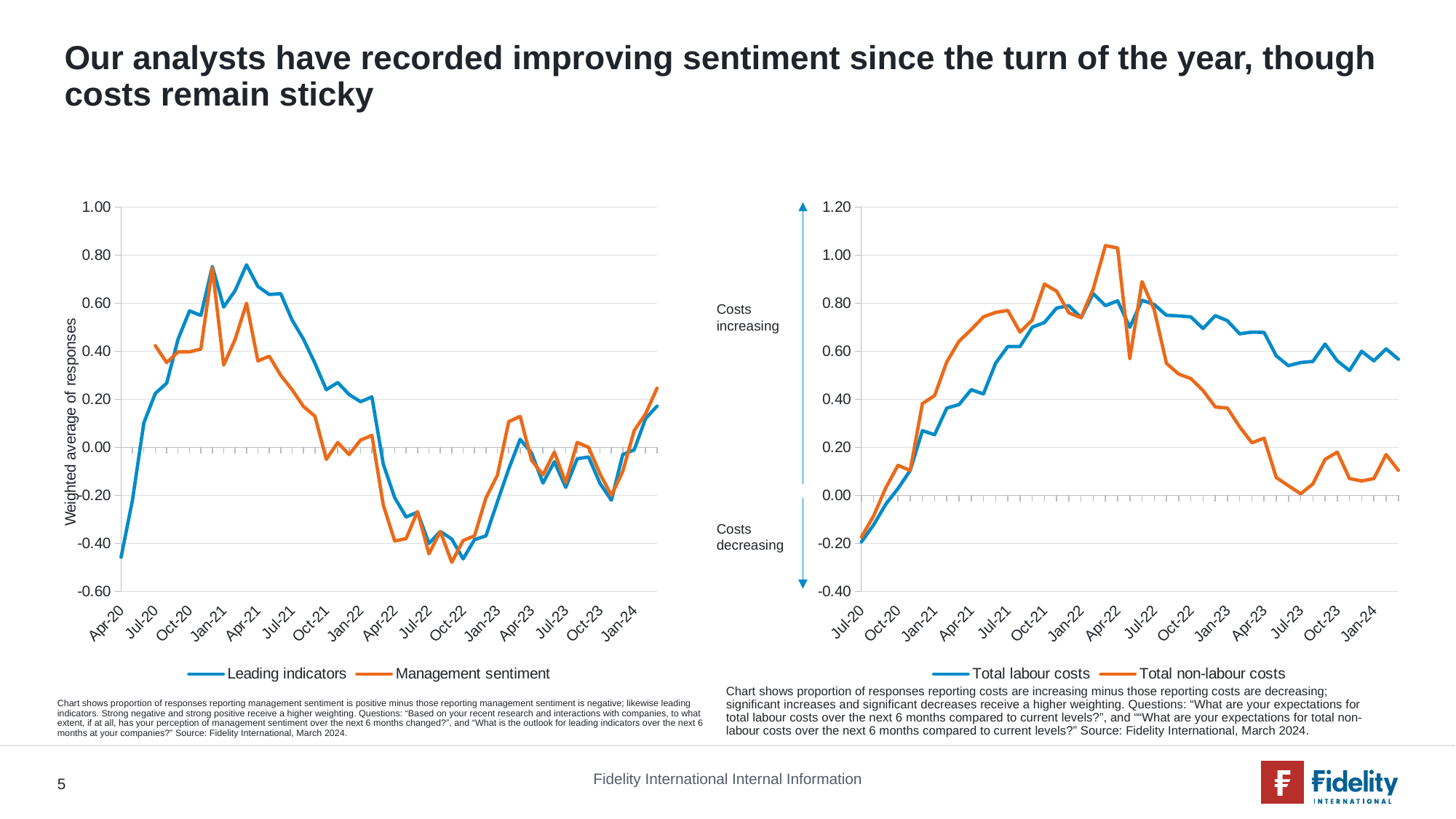
In the right chart, is the value for Total labour costs at Jan-24 greater or less than 0.40? greater In the left chart, which series is higher at Apr-21, Leading indicators or Management sentiment? Leading indicators What are the two series named in the legend of the left chart? Leading indicators and Management sentiment In the left chart, is the value for Management sentiment at Jan-21 greater or less than 0.60? less In the right chart, is the value for Total non-labour costs at Jul-23 greater or less than 0.20? less In the right chart, which series is higher at Jan-24, Total labour costs or Total non-labour costs? Total labour costs How many series does the legend of the right chart list? 2 In the left chart, do the values for Leading indicators rise or fall between Oct-22 and Jan-24? rise What kind of chart is the left chart on the slide? Line chart In the right chart, do the values for Total non-labour costs rise or fall between Apr-22 and Jul-23? fall